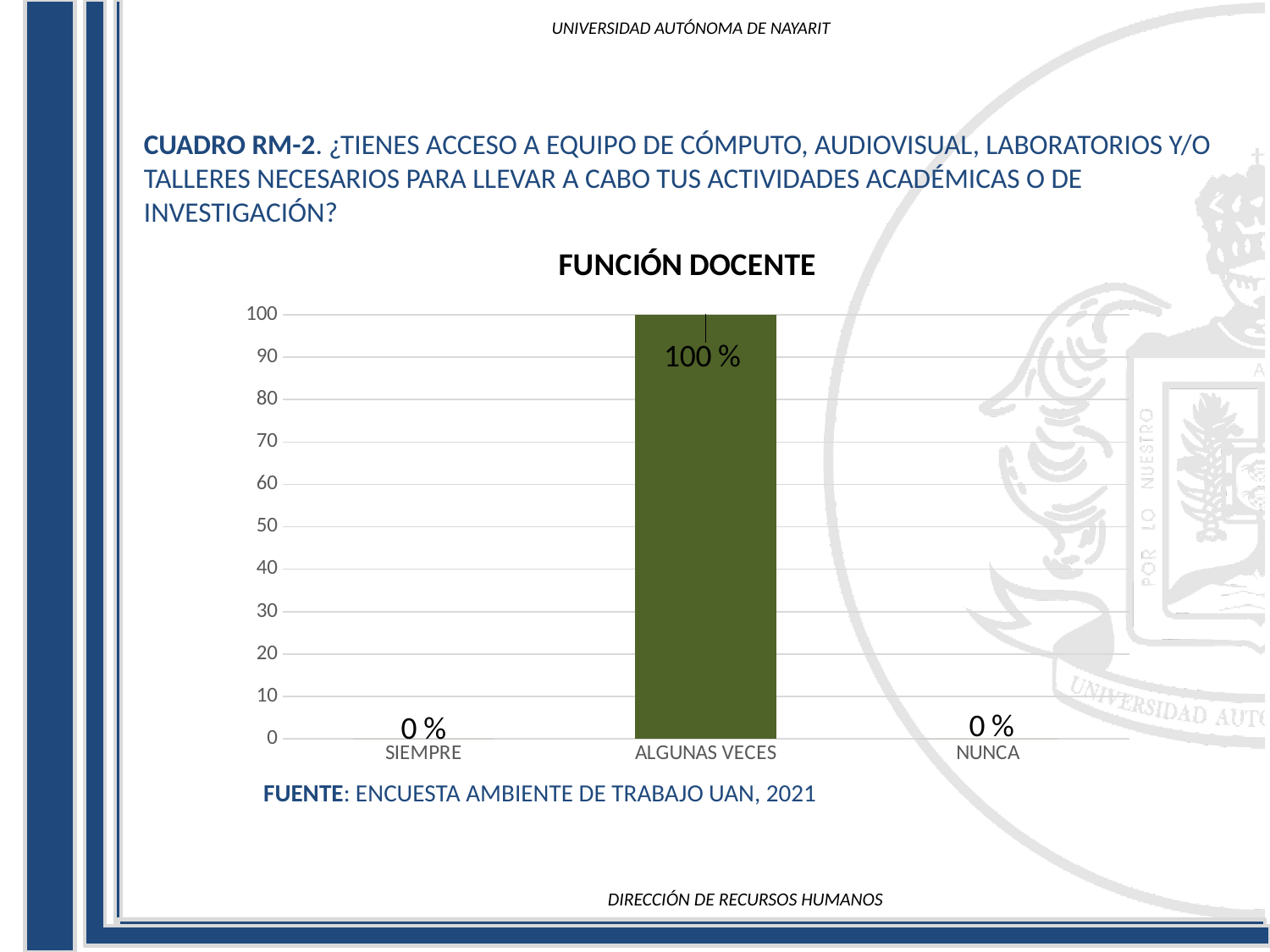
Which is larger, the value for ALGUNAS VECES or the value for NUNCA? ALGUNAS VECES What kind of chart is shown on the slide? bar chart Is the value for ALGUNAS VECES greater or less than 50? greater What is the value for ALGUNAS VECES? 100 % What is the value for NUNCA? 0 % What is the title of the chart? FUNCIÓN DOCENTE How many categories are shown on the x axis? 3 What is the value for SIEMPRE? 0 % Which category has the highest value? ALGUNAS VECES What is the difference between the values for ALGUNAS VECES and SIEMPRE? 100 % What is the highest value shown on the y axis? 100